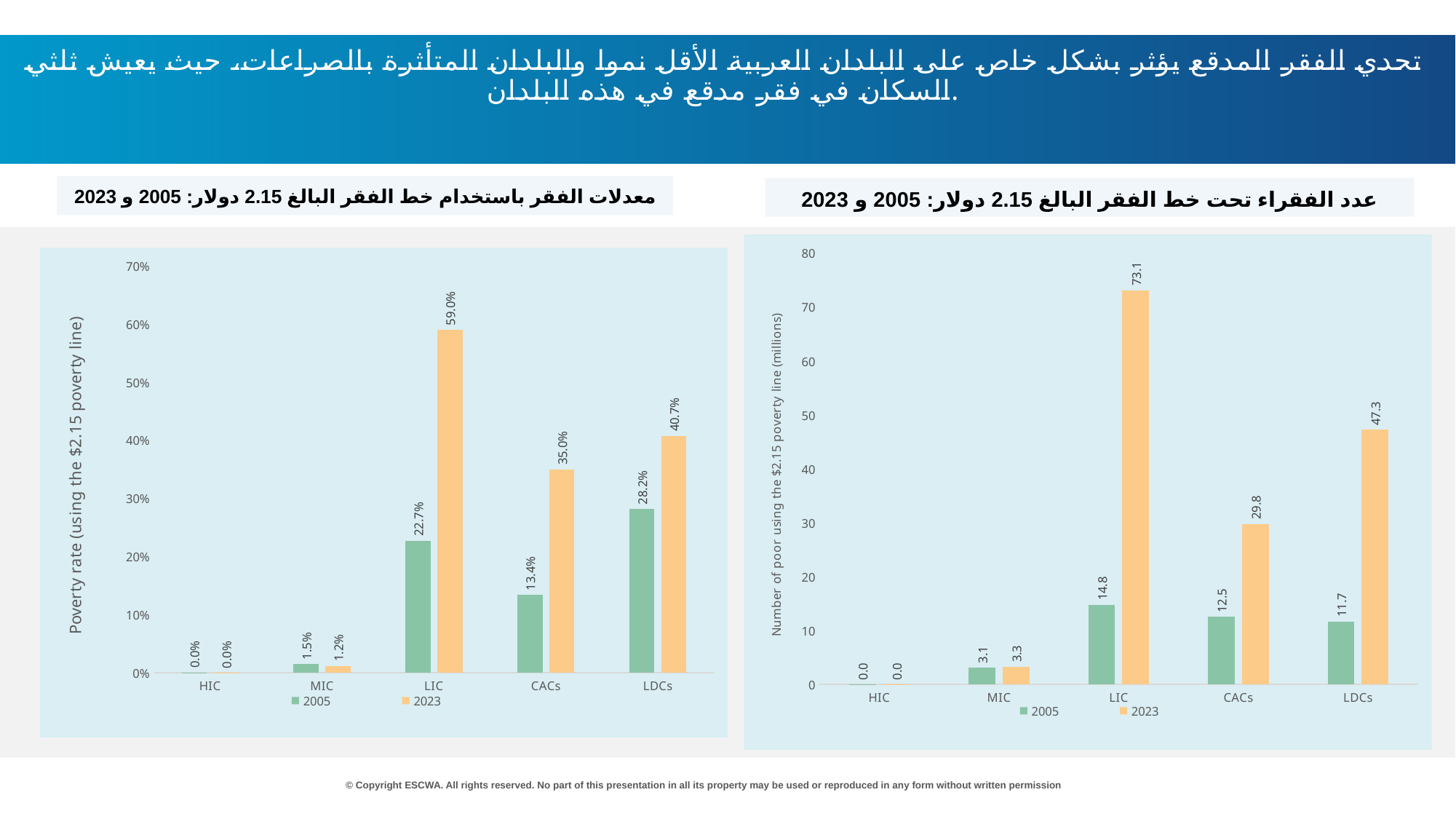
How many categories are shown on the x axis of the left chart (poverty rate)? 5 In the left chart (poverty rate), what is the 2023 value for LIC? 59.0% In the right chart (number of poor), which category has the lowest 2023 value? HIC In the left chart (poverty rate), which category has the highest 2023 value? LIC What type of chart is the left chart (poverty rate)? Bar chart How many series does the legend of the right chart (number of poor) list? 2 In the left chart (poverty rate), what is the difference between the 2023 and 2005 values for CACs? 21.6% In the left chart (poverty rate), what is the 2005 value for LDCs? 28.2% In the right chart (number of poor), what is the difference between the 2023 and 2005 values for LDCs? 35.6 In the right chart (number of poor), which is larger for MIC: the 2005 value or the 2023 value? 2023 In the right chart (number of poor), what is the 2005 value for CACs? 12.5 In the right chart (number of poor), what is the 2023 value for LIC? 73.1